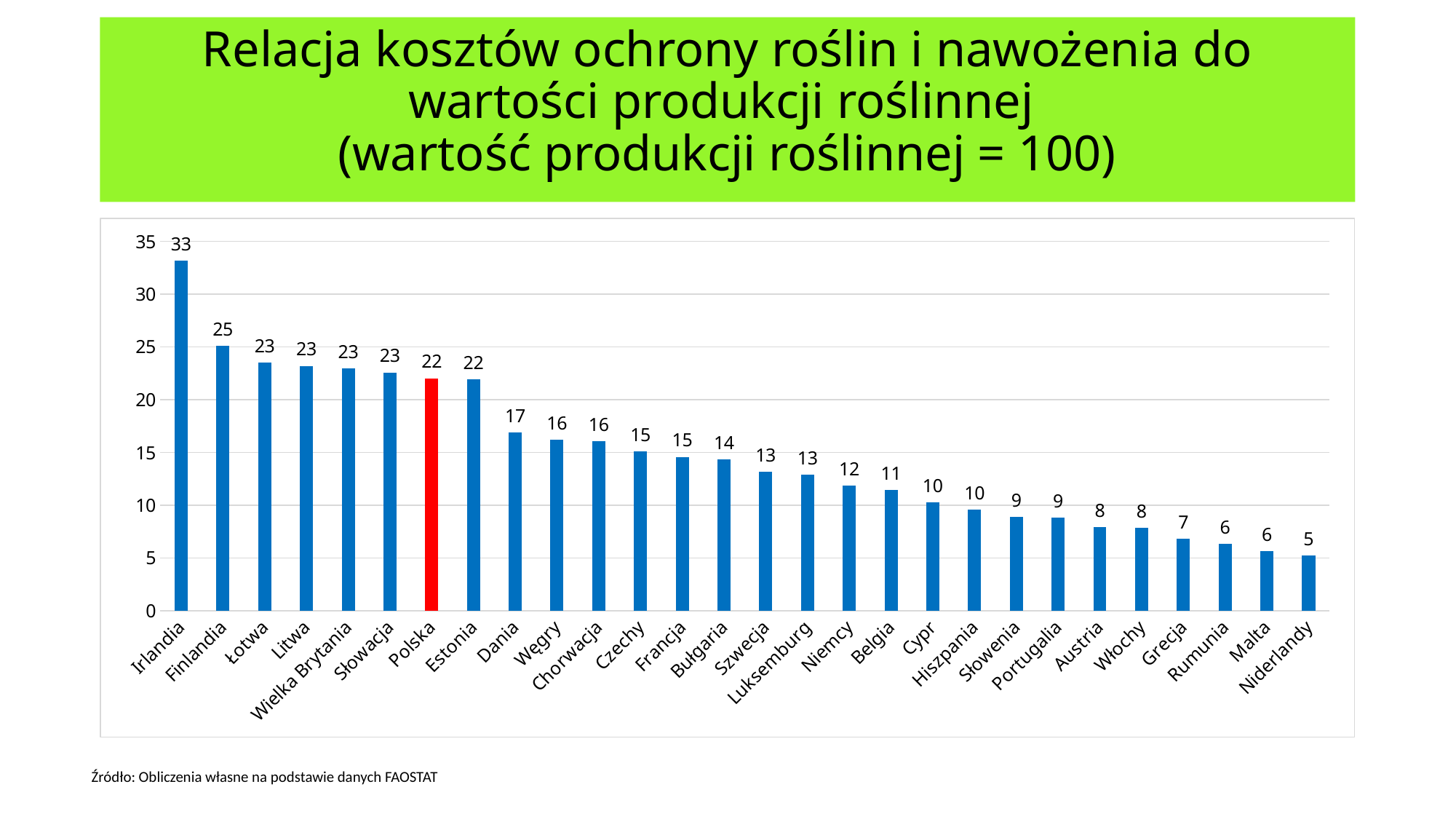
Which country has the highest value? Irlandia What kind of chart is shown on the slide? bar chart What is the difference between the values for Irlandia and Finlandia? 8 Which country's bar is highlighted in red? Polska What is the value for Irlandia? 33 What is the difference between the values for Polska and Niderlandy? 17 What is the value for Niemcy? 12 What is the value for Polska? 22 Which country has the lowest value? Niderlandy Which is larger, the value for Dania or the value for Belgia? Dania How many countries are shown on the chart? 28 Is the value for Finlandia greater or less than 20? greater